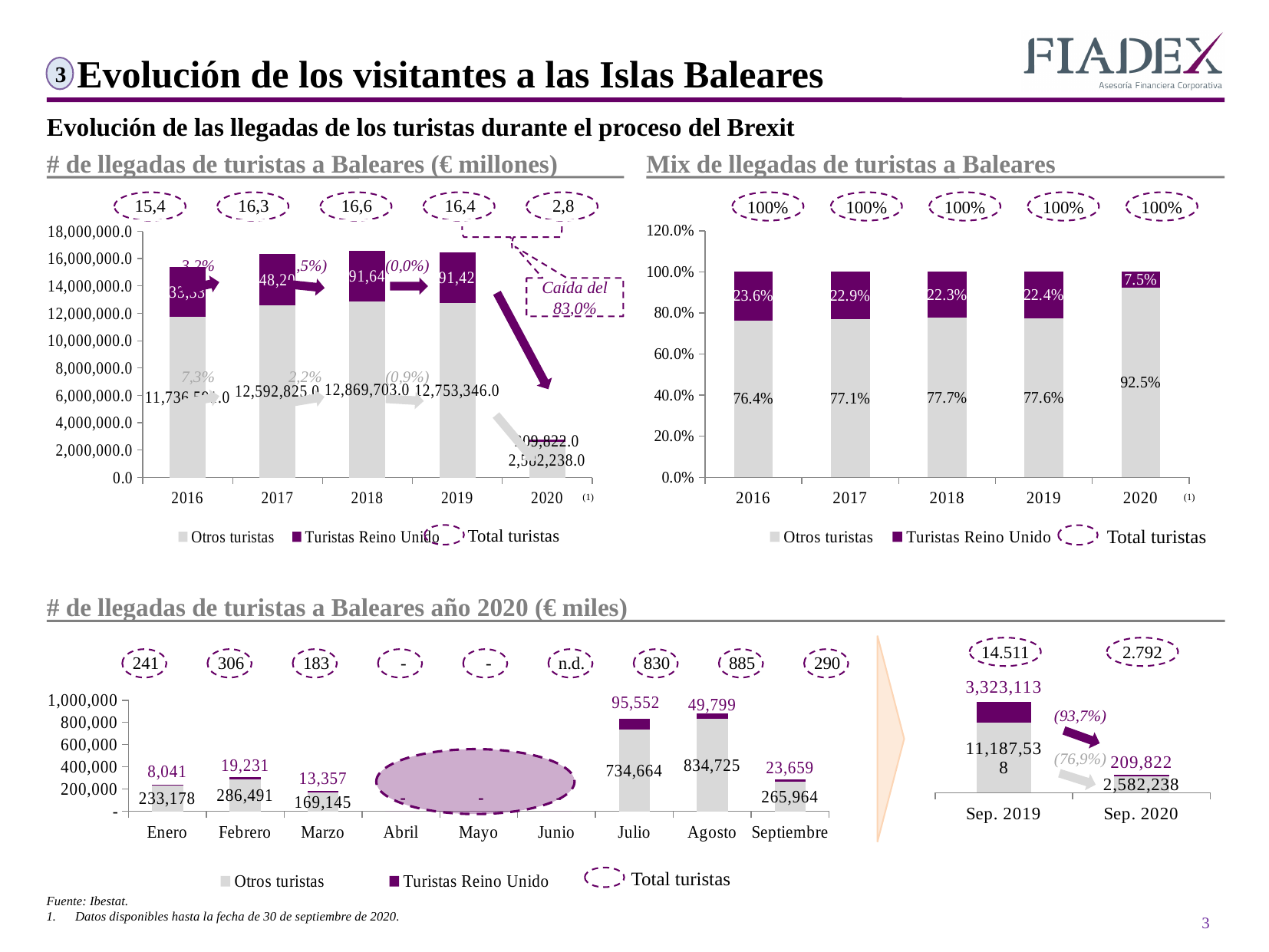
What type of chart is the 'Mix de llegadas de turistas a Baleares' chart? Stacked bar chart In the '# de llegadas de turistas a Baleares (€ millones)' chart, which year has the highest 'Total turistas' value? 2018 In the '# de llegadas de turistas a Baleares (€ millones)' chart, what is the value for 'Otros turistas' in 2018? 12,869,703.0 In the '# de llegadas de turistas a Baleares (€ millones)' chart, what is the 'Total turistas' value shown for 2020? 2,8 In the '# de llegadas de turistas a Baleares año 2020 (€ miles)' chart, how many months are shown on the x axis? 9 In the 'Mix de llegadas de turistas a Baleares' chart, what is the difference between the 'Otros turistas' share in 2018 and in 2016? 1.3% In the '# de llegadas de turistas a Baleares año 2020 (€ miles)' chart, which month has the highest 'Total turistas' value? Agosto In the '# de llegadas de turistas a Baleares año 2020 (€ miles)' chart, what is the value for 'Turistas Reino Unido' in Julio? 95,552 In the 'Mix de llegadas de turistas a Baleares' chart, what is the share of 'Turistas Reino Unido' in 2016? 23.6% In the 'Mix de llegadas de turistas a Baleares' chart, what is the share of 'Otros turistas' in 2020? 92.5% In the '# de llegadas de turistas a Baleares año 2020 (€ miles)' chart, what is the value for 'Otros turistas' in Agosto? 834,725 In the 'Mix de llegadas de turistas a Baleares' chart, which year has the lowest share of 'Turistas Reino Unido'? 2020